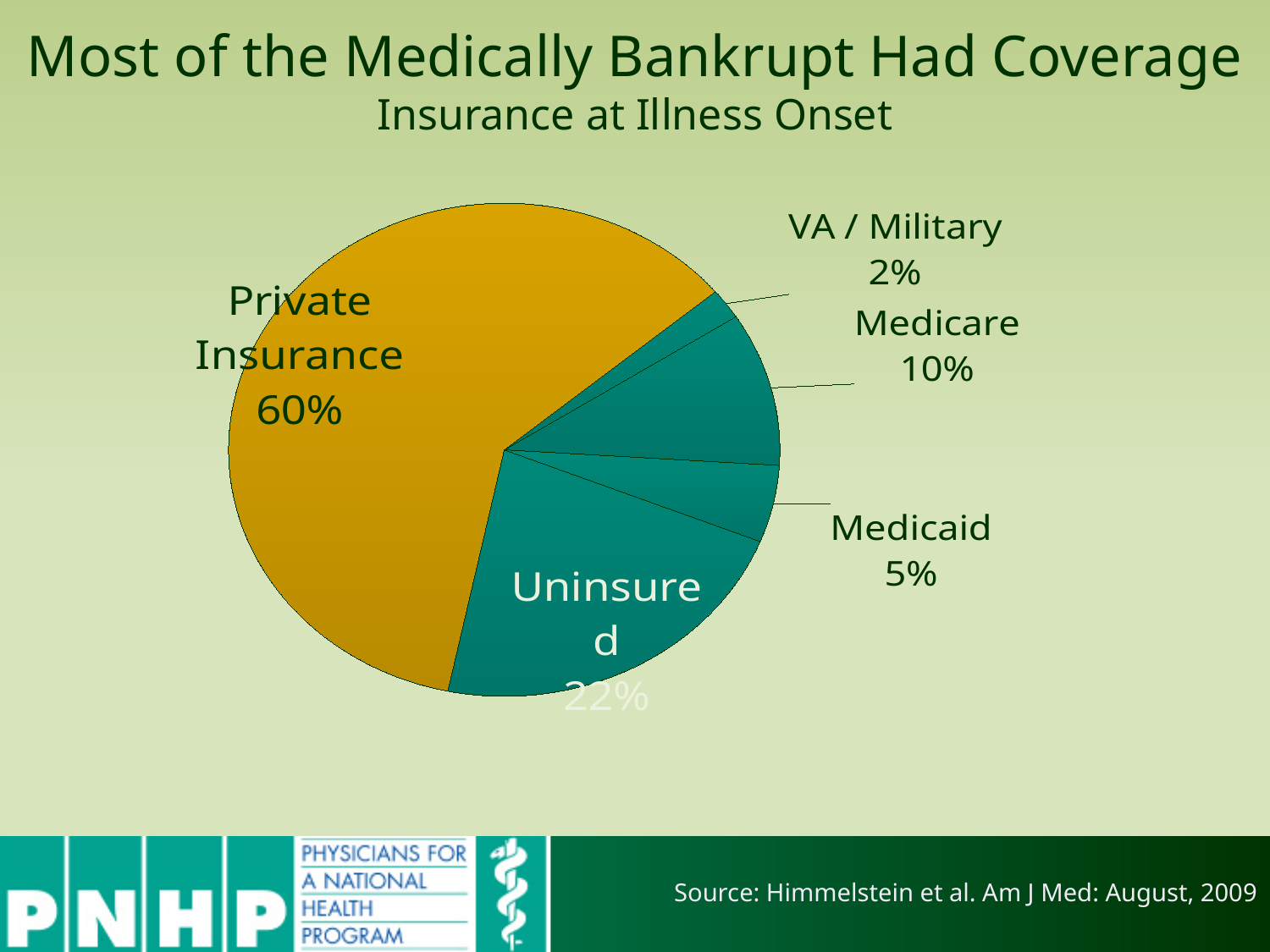
What share of the pie is Private Insurance? 60% Which category has the largest slice of the pie? Private Insurance What kind of chart is shown on the slide? pie chart Which is larger, the Medicare slice or the Medicaid slice? Medicare What share of the pie is Medicare? 10% What is the difference in percentage points between Private Insurance and Uninsured? 38 What share of the pie is Medicaid? 5% Which category has the smallest slice of the pie? VA / Military What share of the pie is VA / Military? 2% How many slices does the pie chart have? 5 What is the subtitle of the chart on the slide? Insurance at Illness Onset What share of the pie is Uninsured? 22%